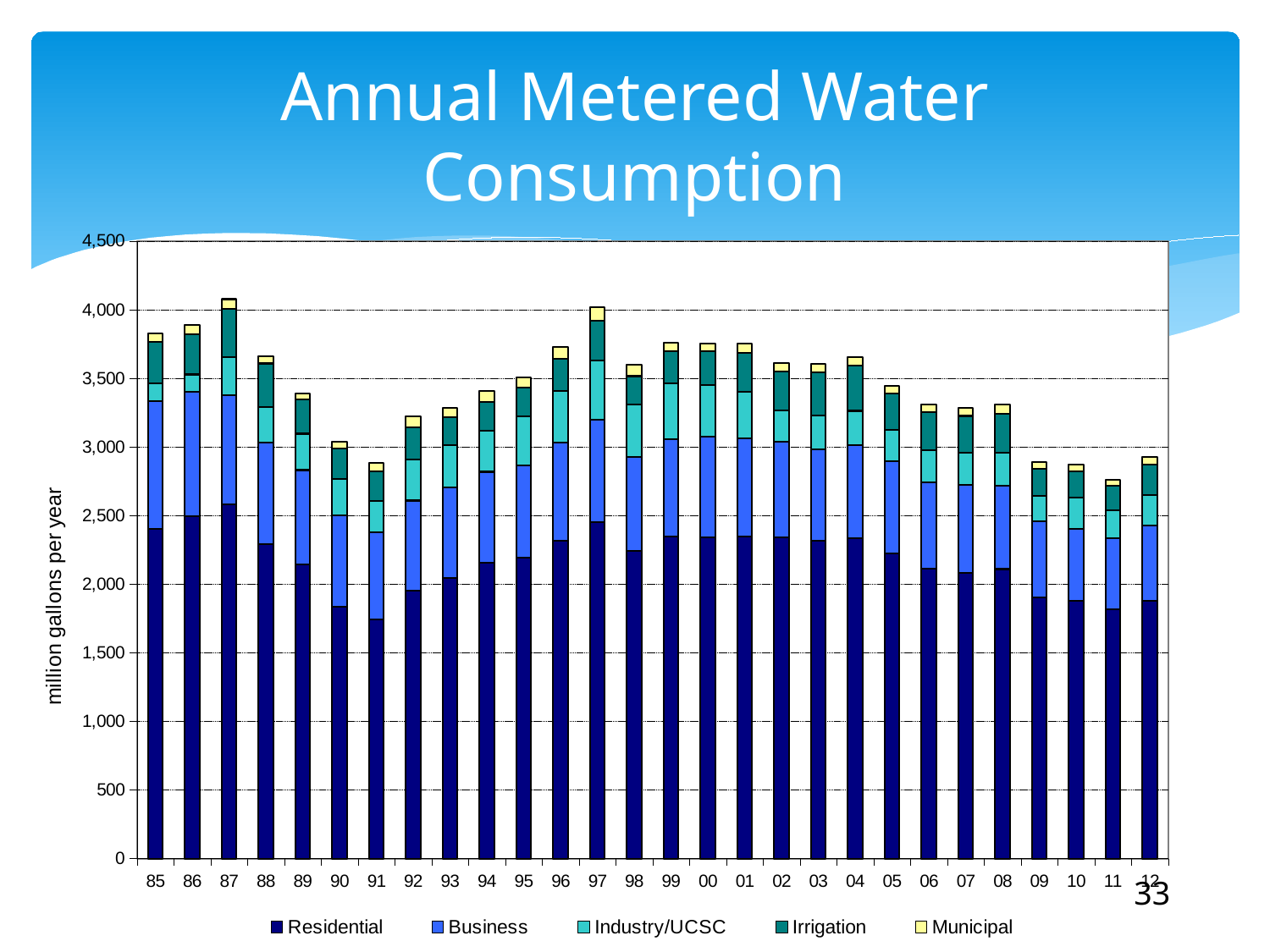
Is the Residential value for 87 greater or less than 2,500? greater What kind of chart is shown on the slide? Stacked bar chart Is the Residential value for 90 greater or less than 2,000? less Is the total consumption for 91 greater or less than 3,000? less Which year has the larger total consumption, 97 or 98? 97 How many series does the legend list? 5 How many years are plotted along the x axis? 28 Which series is shown at the bottom of each stacked bar? Residential What is the label on the y axis? million gallons per year Which year has the lowest total metered water consumption? 11 Do the total consumption values rise or fall from 08 to 11? fall